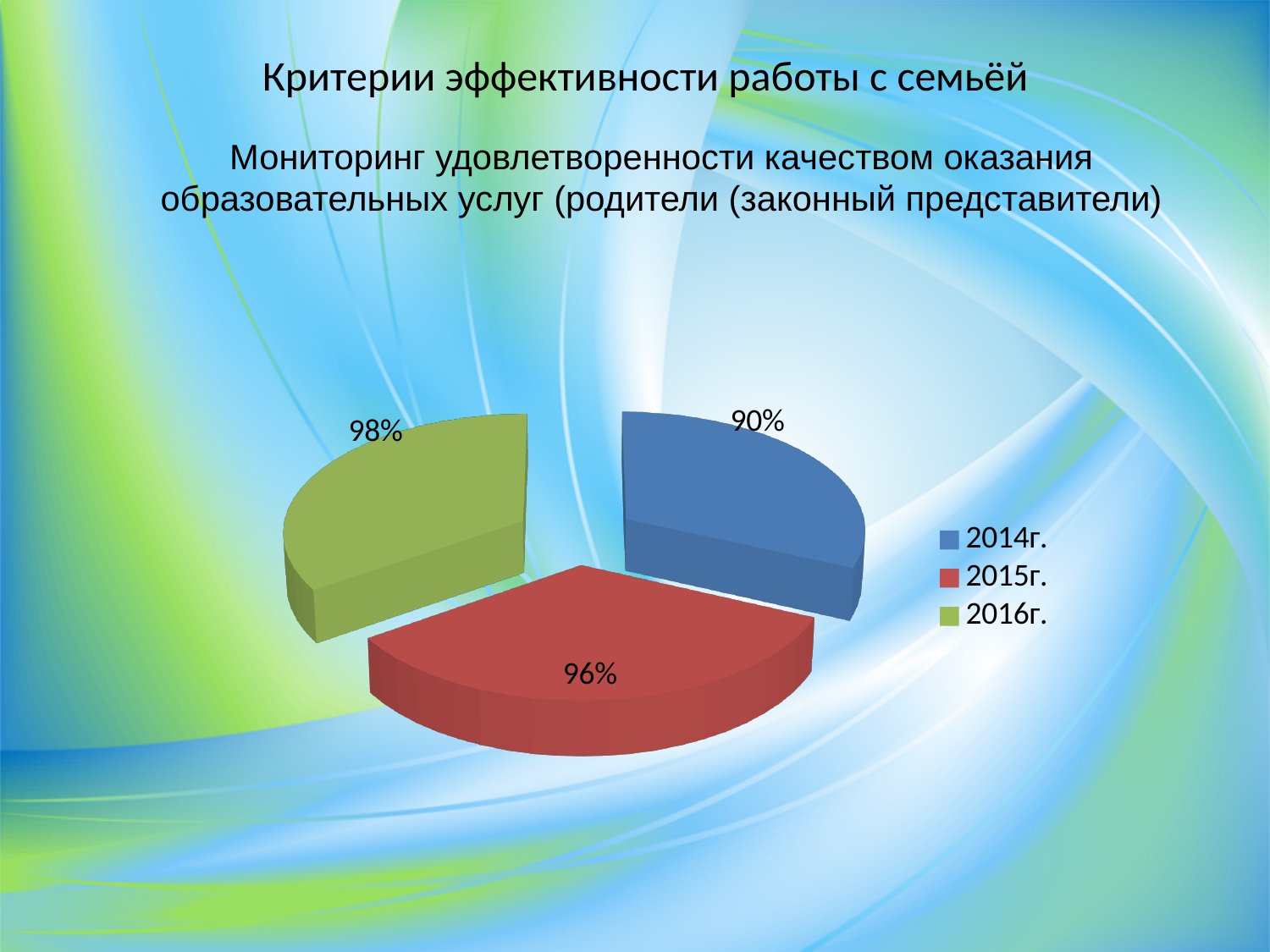
Which is larger, the value for 2015г. or the value for 2016г.? 2016г. Which colour represents 2015г. in the legend? Red What is the difference between the values for 2016г. and 2014г.? 8% What is the difference between the values for 2015г. and 2014г.? 6% What value is shown for 2016г. on the pie chart? 98% Do the values rise or fall from 2014г. to 2016г.? Rise Which year has the lowest value on the pie chart? 2014г. What value is shown for 2014г. on the pie chart? 90% What kind of chart is shown on the slide? Pie chart Which year has the highest value on the pie chart? 2016г. What value is shown for 2015г. on the pie chart? 96% How many slices does the pie chart have? 3